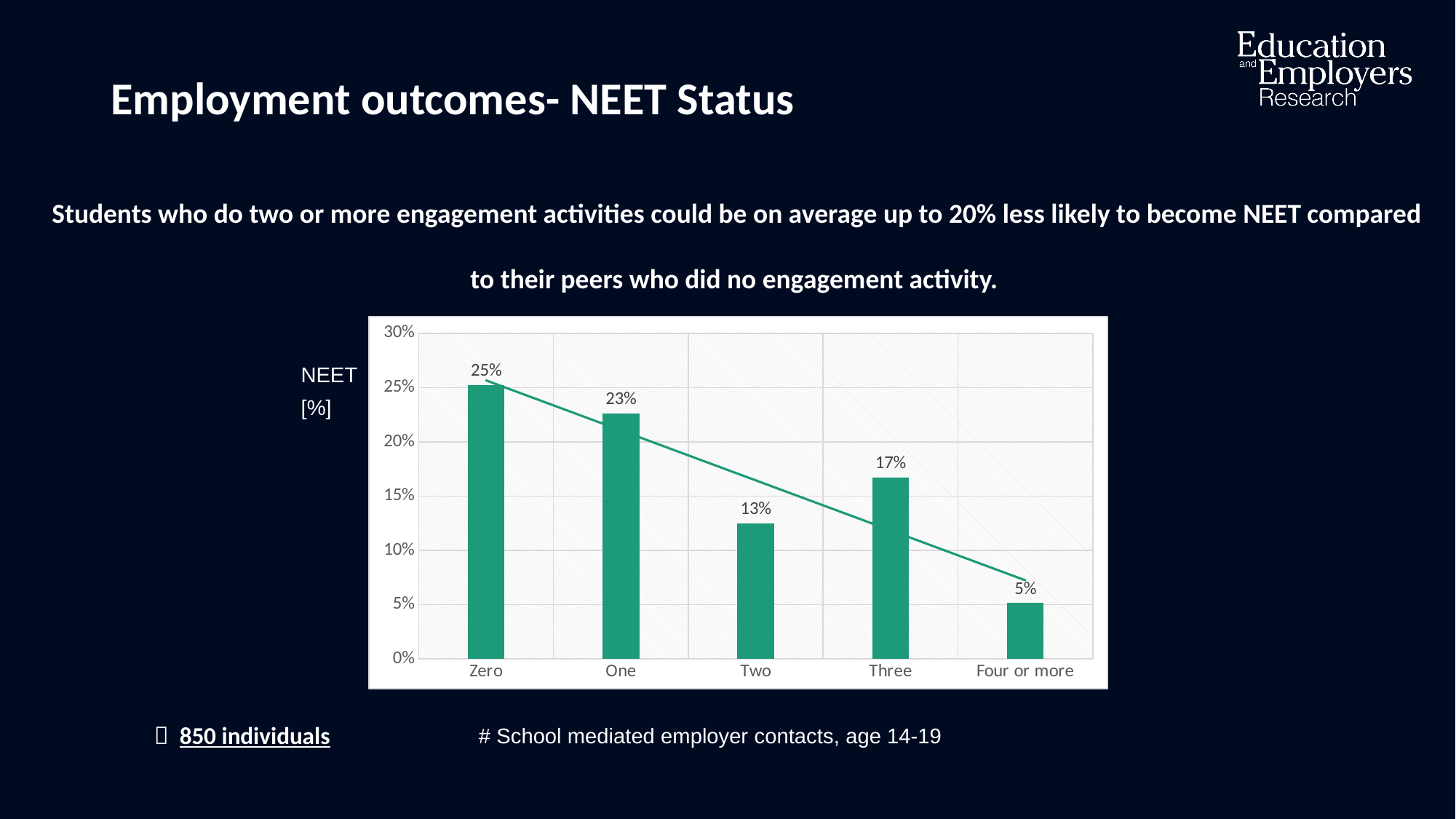
What is the difference in NEET percentage between the 'Zero' and 'Four or more' categories? 20% Which has a higher NEET percentage, 'One' or 'Three'? One Which category has the lowest NEET percentage? Four or more How many categories are shown on the x axis of the chart? 5 Is the NEET percentage for 'Three' greater or less than 15%? greater What is the NEET percentage for students with zero school-mediated employer contacts? 25% What is the NEET percentage for the 'Two' category? 13% What is the NEET percentage for the 'Four or more' category? 5% Which category has the highest NEET percentage? Zero What kind of chart is shown on the slide? Bar chart What is the label on the y axis of the chart? NEET [%] What is the difference in NEET percentage between the 'Three' and 'Two' categories? 4%